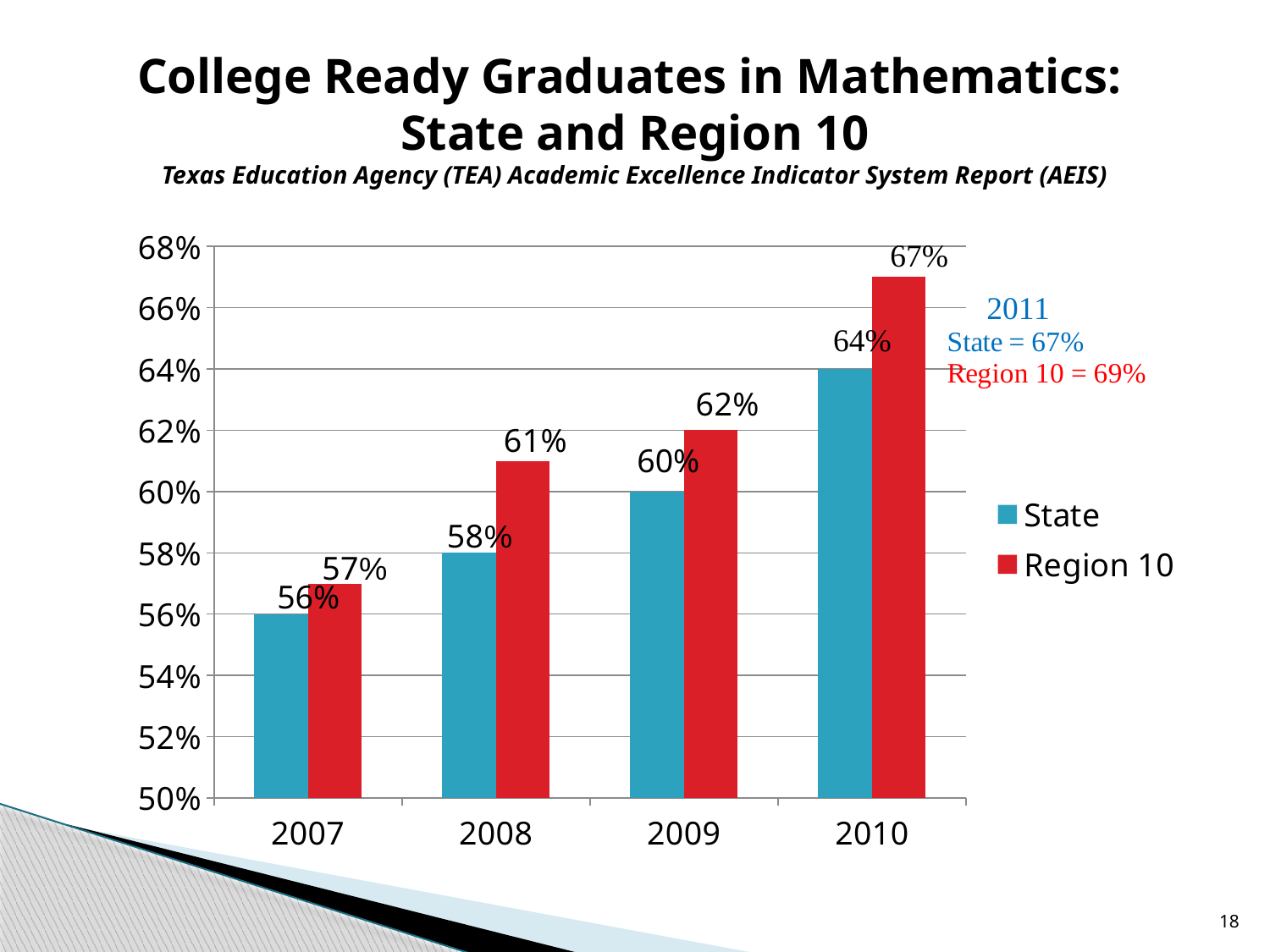
What is the Region 10 value for 2007? 57% What is the State value for 2008? 58% What is the Region 10 value for 2010? 67% How many years are shown on the x axis? 4 In which year is the Region 10 value lowest? 2007 How many series does the legend list? 2 What colour are the Region 10 bars? Red Do the State values rise or fall from 2007 to 2010? Rise What kind of chart is shown? Bar chart What is the difference between the Region 10 and State values in 2010? 3% Which is larger in 2009, the State value or the Region 10 value? Region 10 In which year is the State value highest? 2010